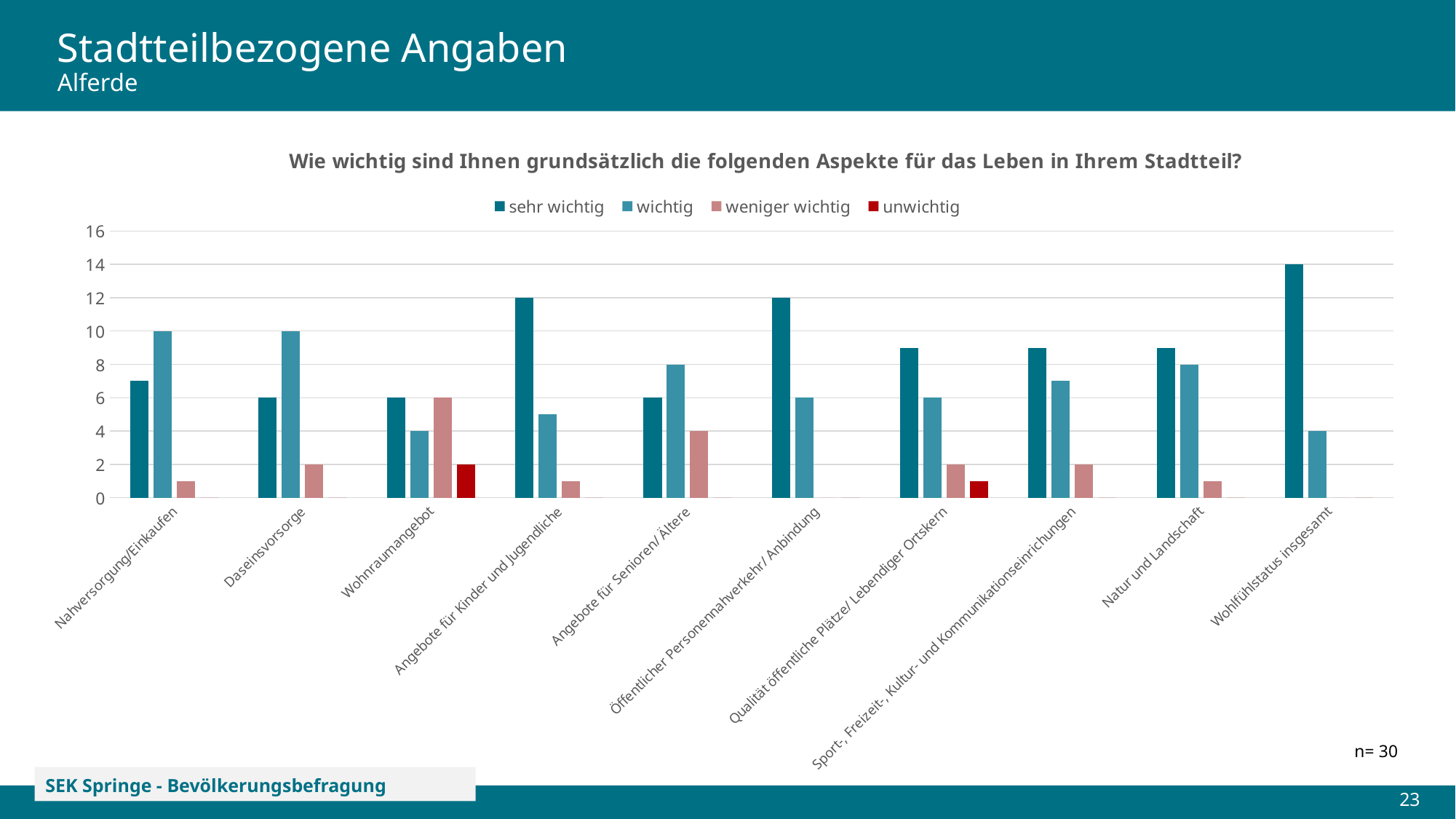
Which category has the highest 'sehr wichtig' value? Wohlfühlstatus insgesamt What is the difference between the 'sehr wichtig' and 'wichtig' values for Wohlfühlstatus insgesamt? 10 What is the 'sehr wichtig' value for Öffentlicher Personennahverkehr/ Anbindung? 12 Is the 'sehr wichtig' value for Angebote für Kinder und Jugendliche greater or less than 10? greater How many categories are shown on the x axis? 10 What is the 'wichtig' value for Nahversorgung/Einkaufen? 10 Is the 'sehr wichtig' value for Nahversorgung/Einkaufen greater or less than 8? less For Angebote für Senioren/ Ältere, which is larger: 'sehr wichtig' or 'wichtig'? wichtig How many series does the legend list? 4 What is the 'sehr wichtig' value for Wohlfühlstatus insgesamt? 14 What is the 'weniger wichtig' value for Angebote für Senioren/ Ältere? 4 What kind of chart is shown on the slide? bar chart